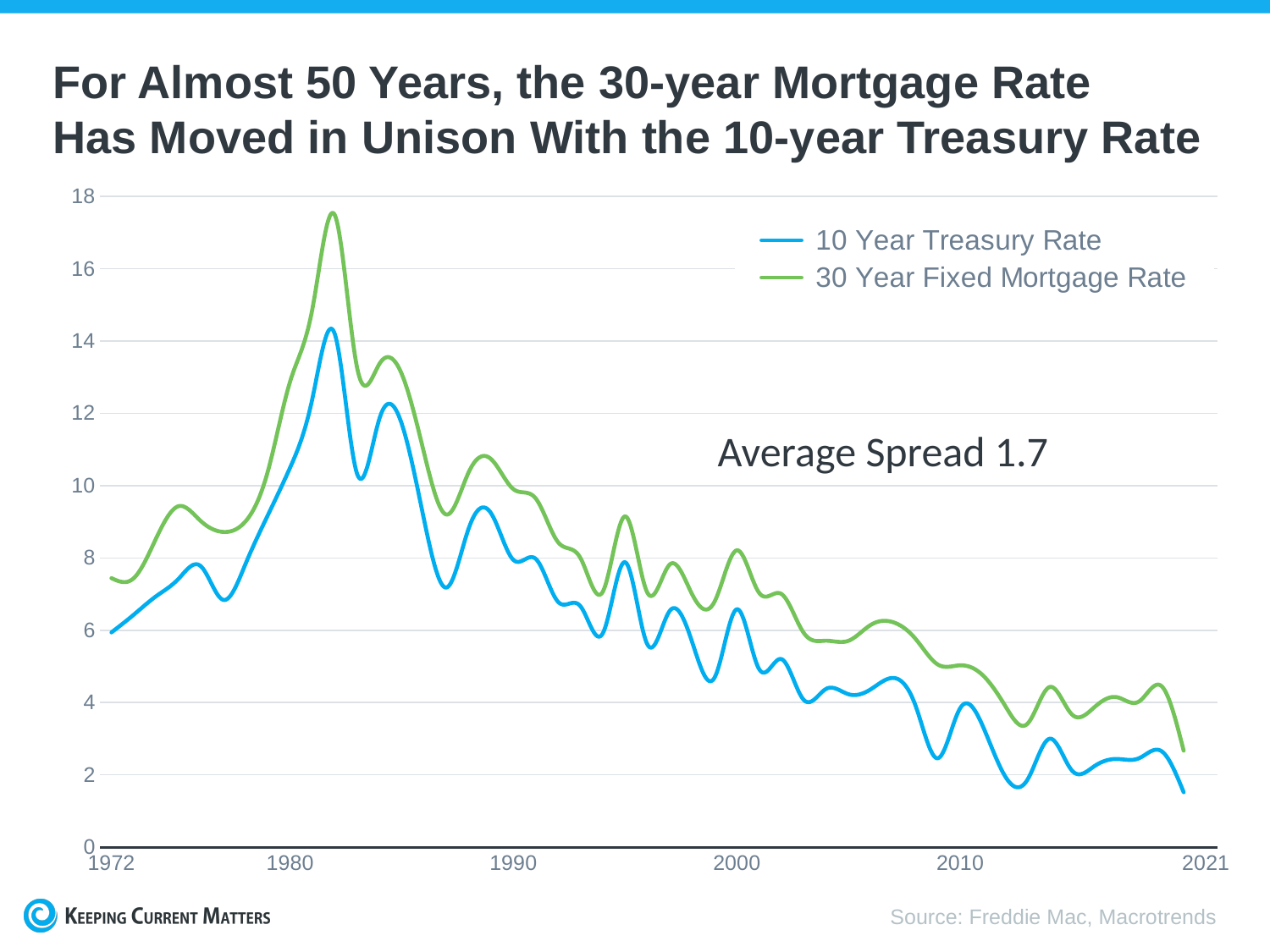
Which series is higher throughout the chart, the 10 Year Treasury Rate or the 30 Year Fixed Mortgage Rate? 30 Year Fixed Mortgage Rate Which colour line represents the 10 Year Treasury Rate? Blue Is the 30 Year Fixed Mortgage Rate in 2010 greater or less than 6? less Do both rates generally rise or fall from 1990 to 2021? Fall What average spread between the two rates is stated on the chart? 1.7 Is the 10 Year Treasury Rate at the end of the chart (2021) greater or less than 2? less Is the peak value of the 10 Year Treasury Rate greater or less than 12? greater Between which two labelled years on the x axis do both rates reach their peak? 1980 and 1990 How many series does the legend list? 2 What kind of chart is shown on the slide? Line chart